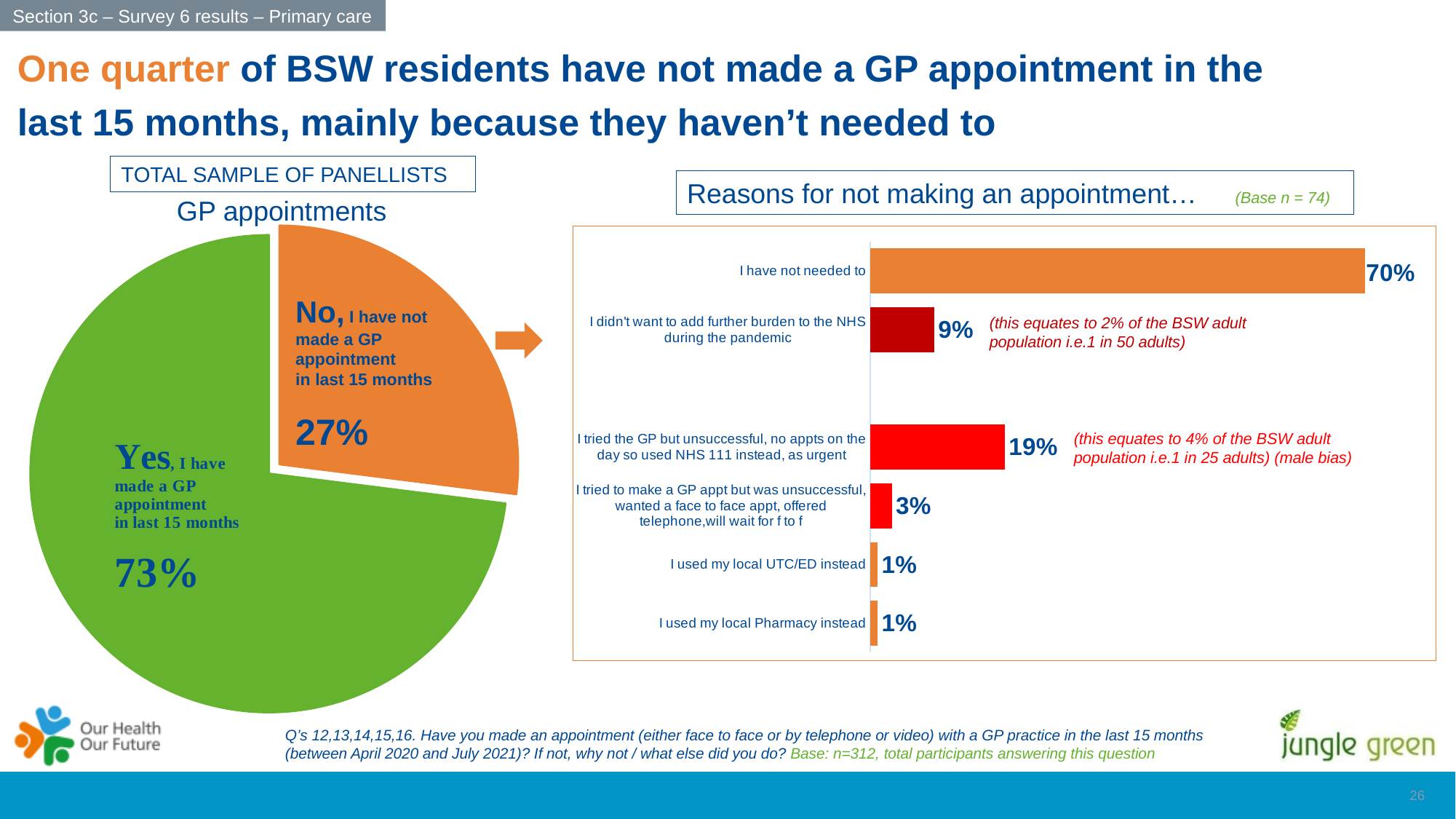
In the 'Reasons for not making an appointment' chart, what is the difference between 'I have not needed to' and 'I tried the GP but unsuccessful, no appts on the day so used NHS 111 instead, as urgent'? 51% In the 'Reasons for not making an appointment' chart, what is the value for 'I have not needed to'? 70% In the 'Reasons for not making an appointment' chart, which is larger: 'I didn't want to add further burden to the NHS during the pandemic' or 'I tried to make a GP appt but was unsuccessful, wanted a face to face appt, offered telephone, will wait for f to f'? I didn't want to add further burden to the NHS during the pandemic In the 'Reasons for not making an appointment' chart, what is the value for 'I didn't want to add further burden to the NHS during the pandemic'? 9% What kind of chart is the 'GP appointments' chart on the left? Pie chart In the 'GP appointments' pie chart, what share of panellists said Yes, they have made a GP appointment in the last 15 months? 73% In the 'Reasons for not making an appointment' chart, which reason has the highest value? I have not needed to How many reasons are listed in the 'Reasons for not making an appointment' chart? 6 In the 'Reasons for not making an appointment' chart, what is the value for 'I tried the GP but unsuccessful, no appts on the day so used NHS 111 instead, as urgent'? 19% What kind of chart is the 'Reasons for not making an appointment' chart? Bar chart In the 'GP appointments' pie chart, what share of panellists said No, they have not made a GP appointment in the last 15 months? 27% How many slices does the 'GP appointments' pie chart have? 2